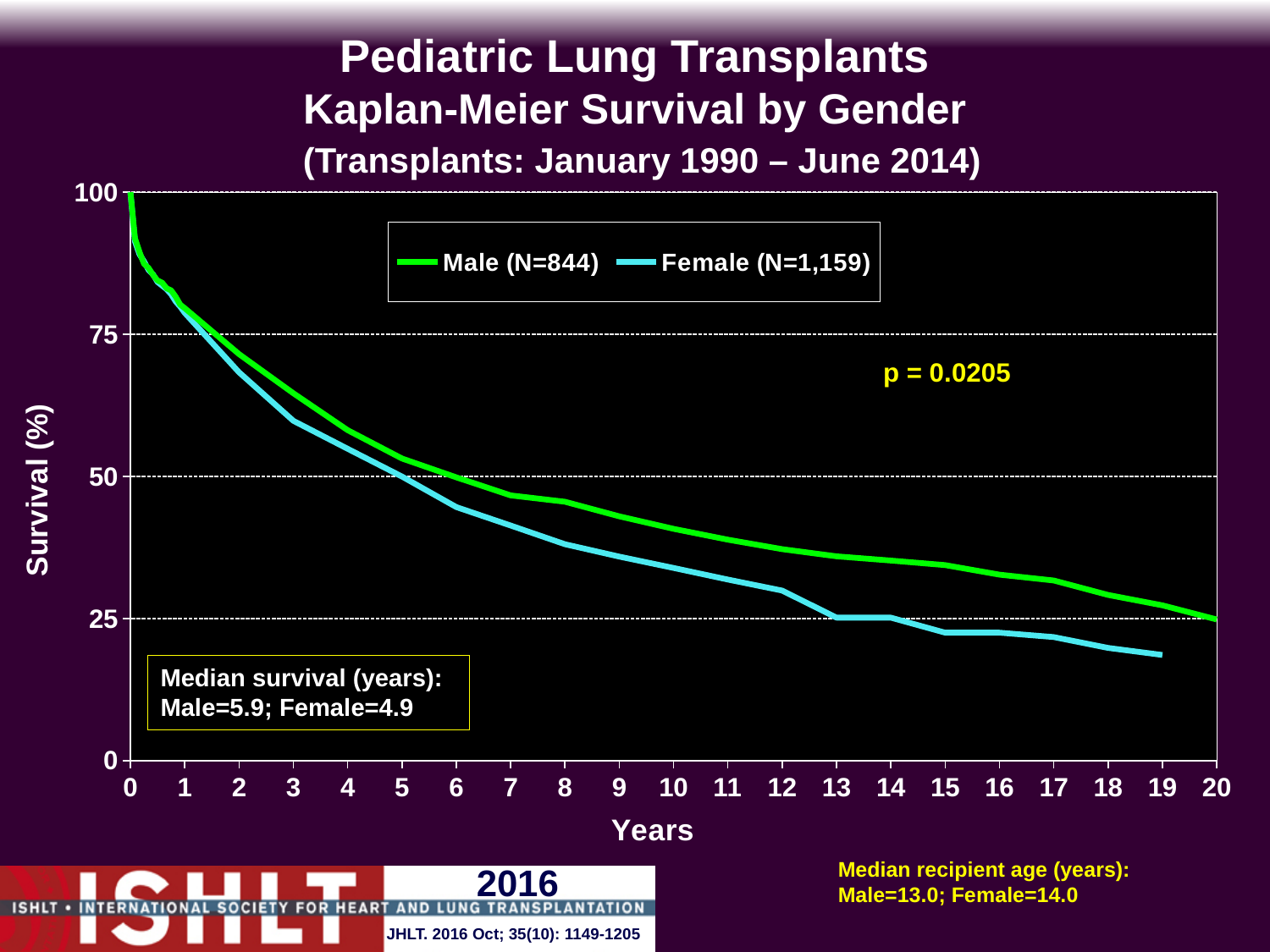
Is the Male survival value at 3 years greater or less than 50? greater Is the Female survival value at 15 years greater or less than 25? less Which group has the longer median survival, Male or Female? Male What is the difference in median survival (years) between males and females? 1.0 What kind of chart is shown on the slide? line chart What is the median survival in years for females, as printed on the chart? 4.9 Do the survival curves rise or fall as years increase? fall What is the median survival in years for males, as printed on the chart? 5.9 How many series does the legend list? 2 Is the Male survival value at 10 years greater or less than 50? less At 10 years, which curve shows higher survival, Male or Female? Male What is the p-value shown on the chart? p = 0.0205